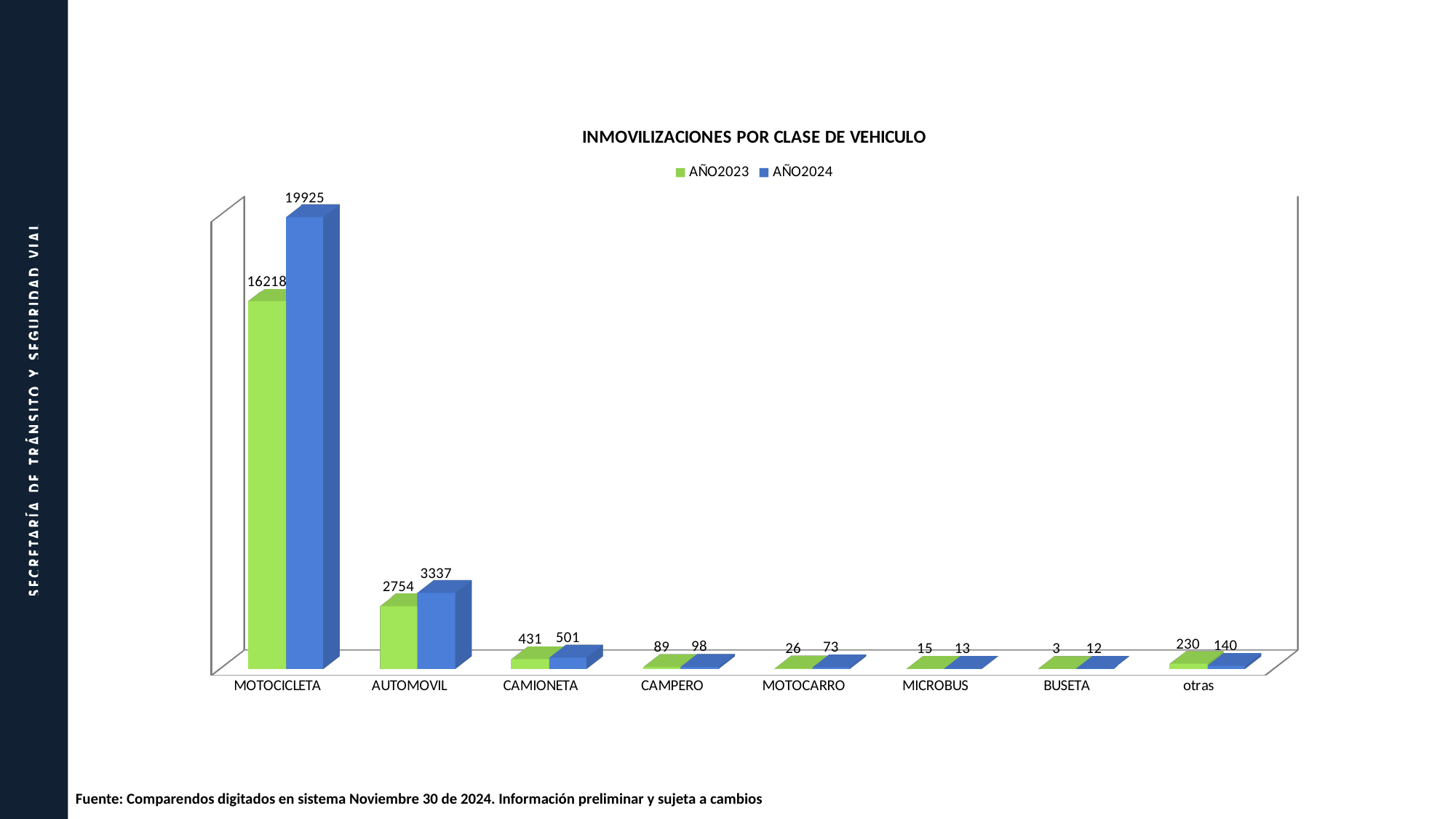
What is the title of the chart? INMOVILIZACIONES POR CLASE DE VEHICULO How many series does the legend list? 2 What is the value for MOTOCICLETA in the AÑO2024 series? 19925 What is the difference between the AÑO2024 and AÑO2023 values for MOTOCICLETA? 3707 Which category has the lowest value in the AÑO2023 series? BUSETA Which category has the highest value in the AÑO2024 series? MOTOCICLETA What is the value for AUTOMOVIL in the AÑO2023 series? 2754 Which is larger for otras: the AÑO2023 value or the AÑO2024 value? AÑO2023 What kind of chart is shown on the slide? Bar chart What is the value for CAMIONETA in the AÑO2024 series? 501 What is the value for BUSETA in the AÑO2023 series? 3 How many vehicle categories are shown on the x axis? 8